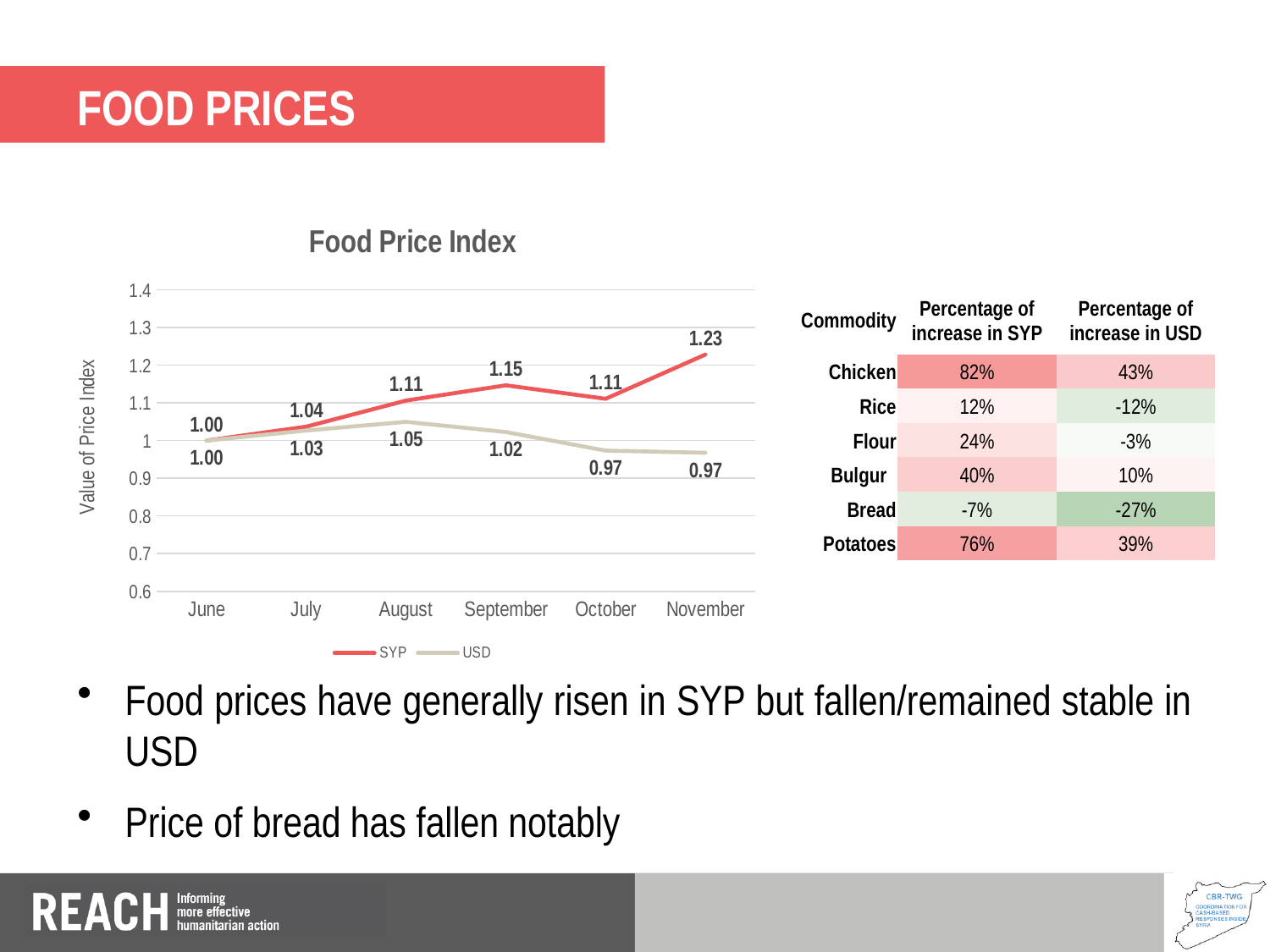
In which month is the SYP Food Price Index lowest? June What is the USD value of the Food Price Index in October? 0.97 How many months are plotted on the x axis of the Food Price Index chart? 6 What is the difference between the SYP and USD values of the Food Price Index in November? 0.26 Does the USD Food Price Index rise or fall from August to October? fall Is the USD value of the Food Price Index in November greater or less than 1? less In which month is the SYP Food Price Index highest? November What is the SYP value of the Food Price Index in November? 1.23 How many series does the legend of the Food Price Index chart list? 2 What is the SYP value of the Food Price Index in September? 1.15 What kind of chart is the Food Price Index chart? line chart Which is larger in August, the SYP value or the USD value of the Food Price Index? SYP